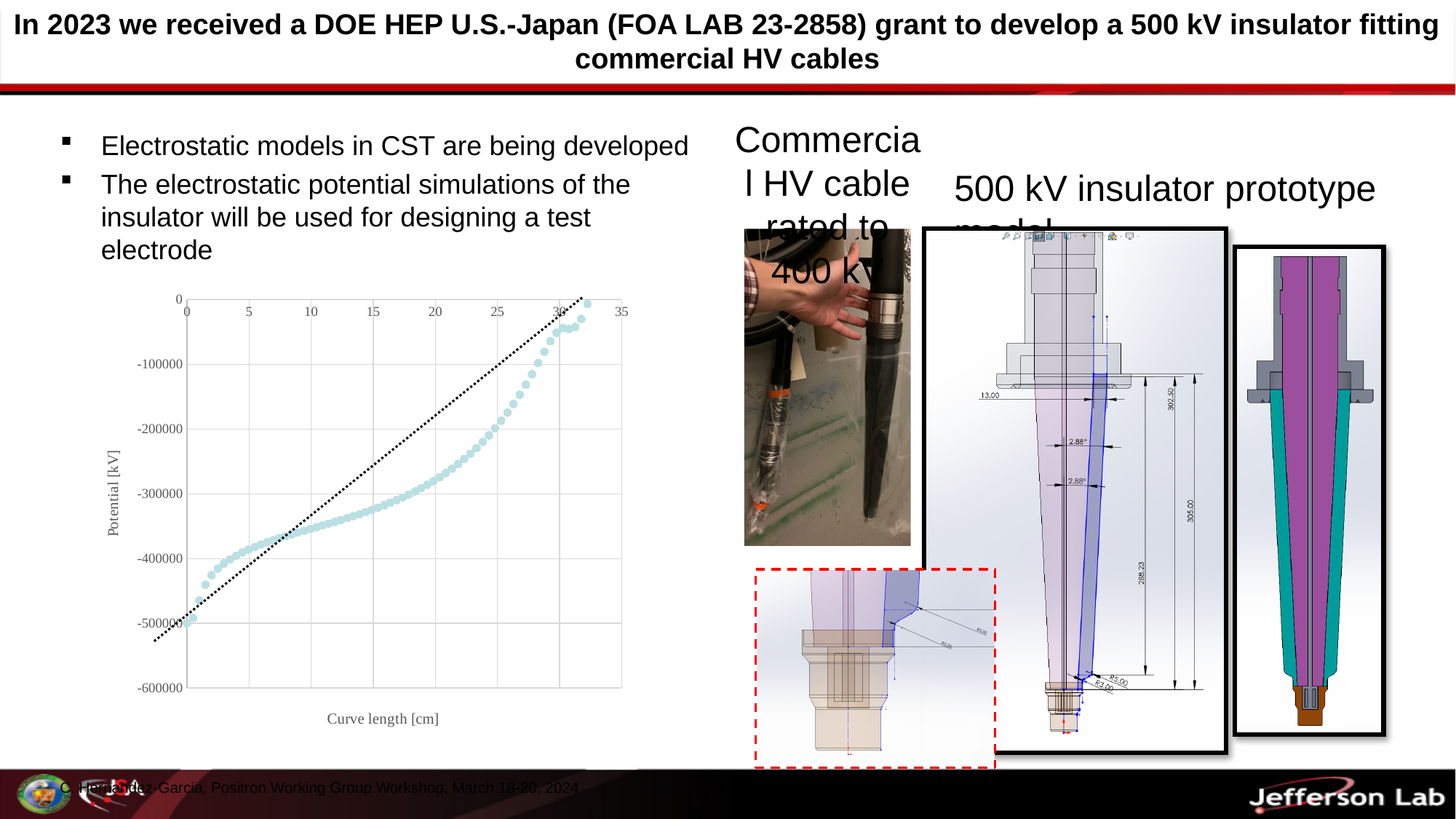
Is the potential at a curve length of 5 cm greater or less than -300000? less Is the potential at a curve length of 30 cm greater or less than -100000? greater What is the label of the x axis of the chart? Curve length [cm] What is the label of the y axis of the chart? Potential [kV] Is the potential at a curve length of 0 cm greater or less than -400000? less What kind of chart is shown on the slide? scatter chart At which curve length is the plotted potential lowest? 0 cm Which is larger, the potential at a curve length of 5 cm or at 25 cm? 25 cm Do the plotted potential values rise or fall as curve length increases along the x axis? rise